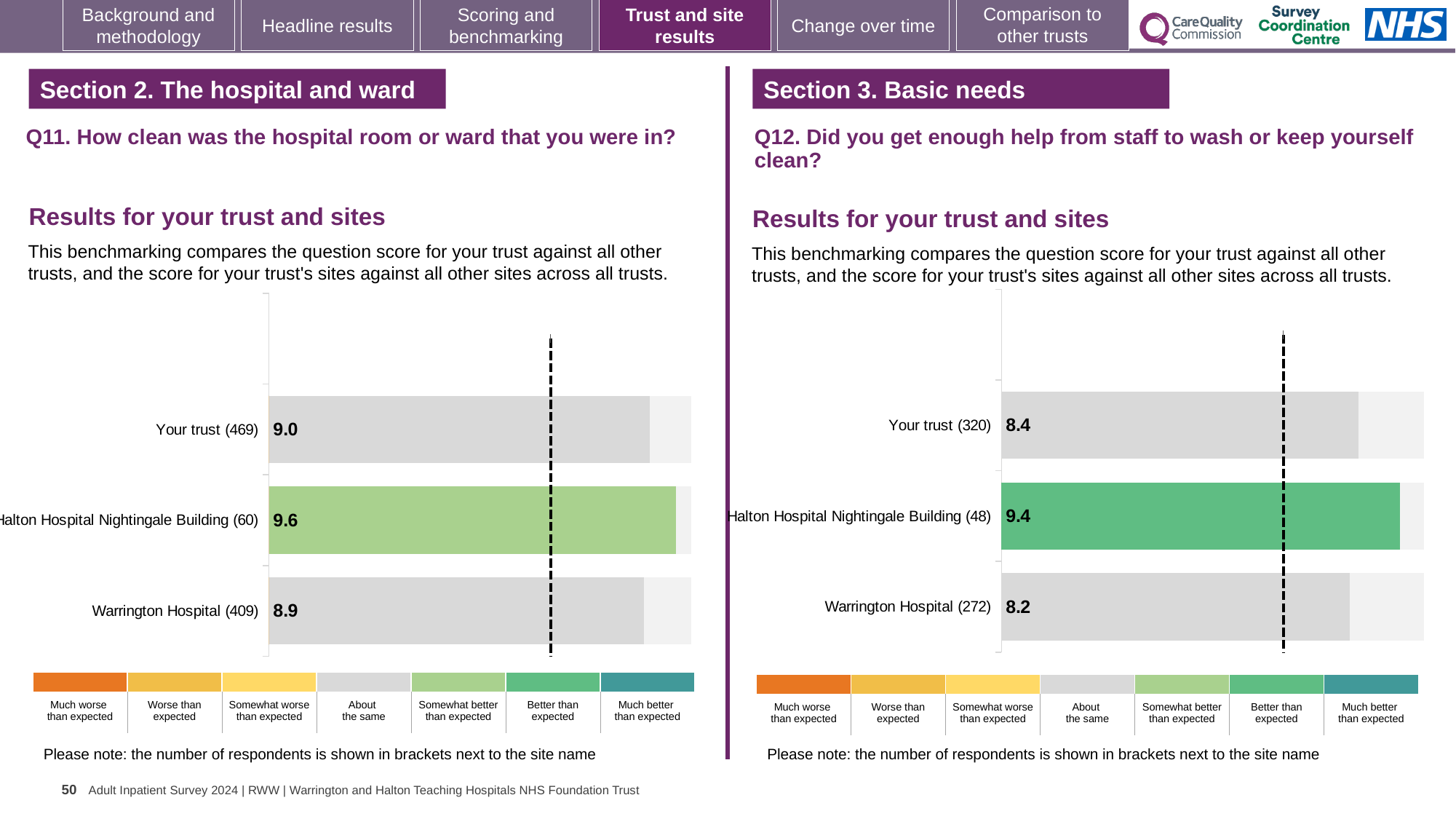
In the Q12 chart (right), which has the larger score, Your trust or Warrington Hospital? Your trust In the Q11 chart (left), which site or trust has the highest score? Halton Hospital Nightingale Building In the Q11 chart (left), what is the score for Halton Hospital Nightingale Building? 9.6 In the Q12 chart (right), what is the score for Your trust? 8.4 What type of chart is used in the Q12 chart (right)? Bar chart In the Q12 chart (right), what is the score for Halton Hospital Nightingale Building? 9.4 In the Q11 chart (left), how many bars are plotted? 3 In the Q11 chart (left), what is the score for Warrington Hospital? 8.9 In the Q11 chart (left), what is the difference between the scores for Halton Hospital Nightingale Building and Warrington Hospital? 0.7 In the Q11 chart (left), what is the score for Your trust? 9.0 In the Q12 chart (right), what is the difference between the scores for Halton Hospital Nightingale Building and Your trust? 1.0 In the Q12 chart (right), which site or trust has the lowest score? Warrington Hospital